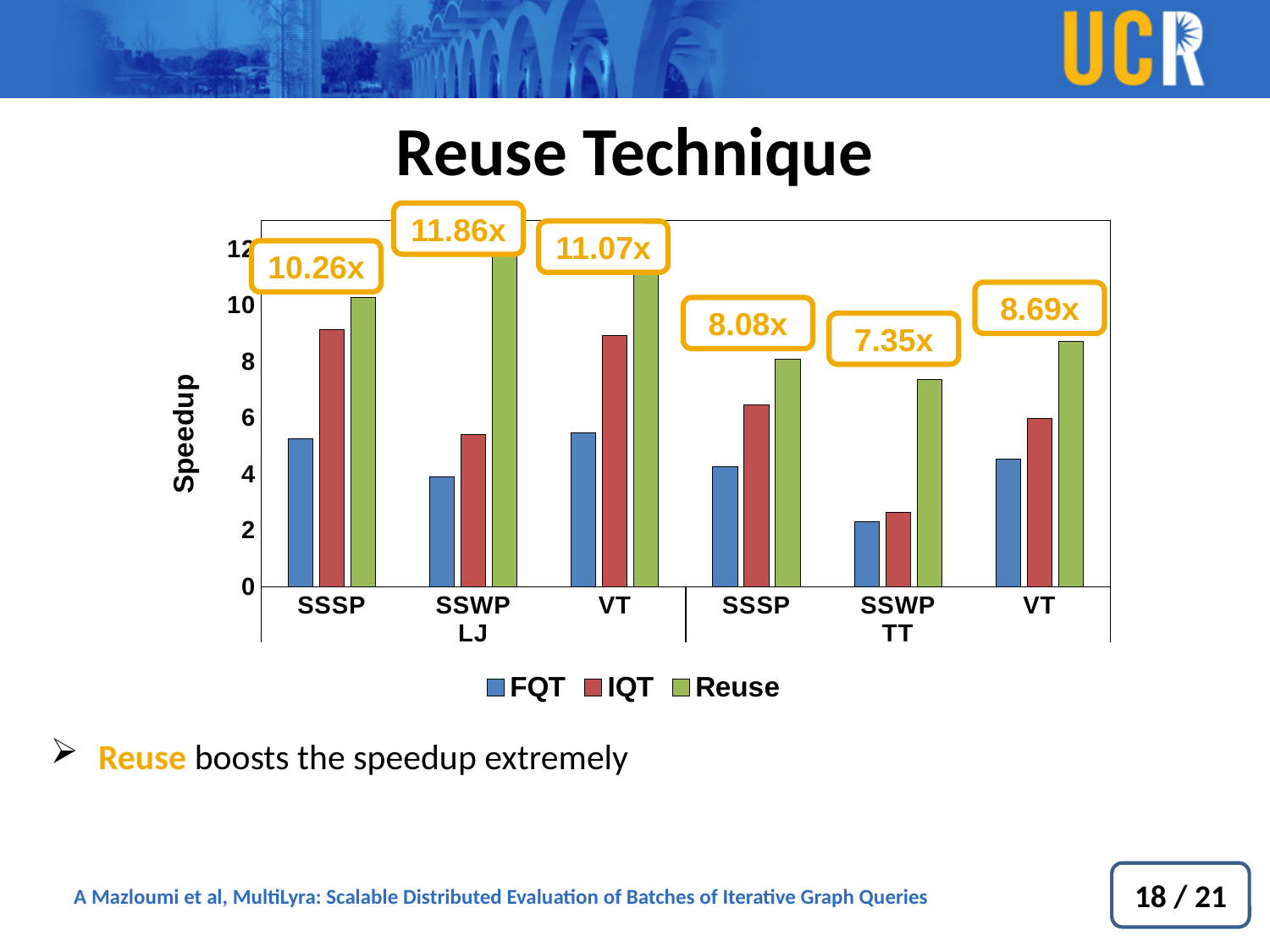
Which category has the lowest Reuse speedup? SSWP on TT What is the Reuse speedup for SSWP on LJ? 11.86x Is the FQT value for SSWP on TT greater or less than 4? less Which category has the highest Reuse speedup? SSWP on LJ What is the Reuse speedup for SSWP on TT? 7.35x What is the difference between the Reuse speedup for SSWP on LJ and SSWP on TT? 4.51x What is the label of the y axis? Speedup Which is larger, the Reuse speedup for VT on LJ or VT on TT? VT on LJ What is the Reuse speedup for SSSP on LJ? 10.26x What kind of chart is shown on the slide? bar chart How many series does the legend list? 3 Is the IQT value for SSSP on LJ greater or less than 8? greater